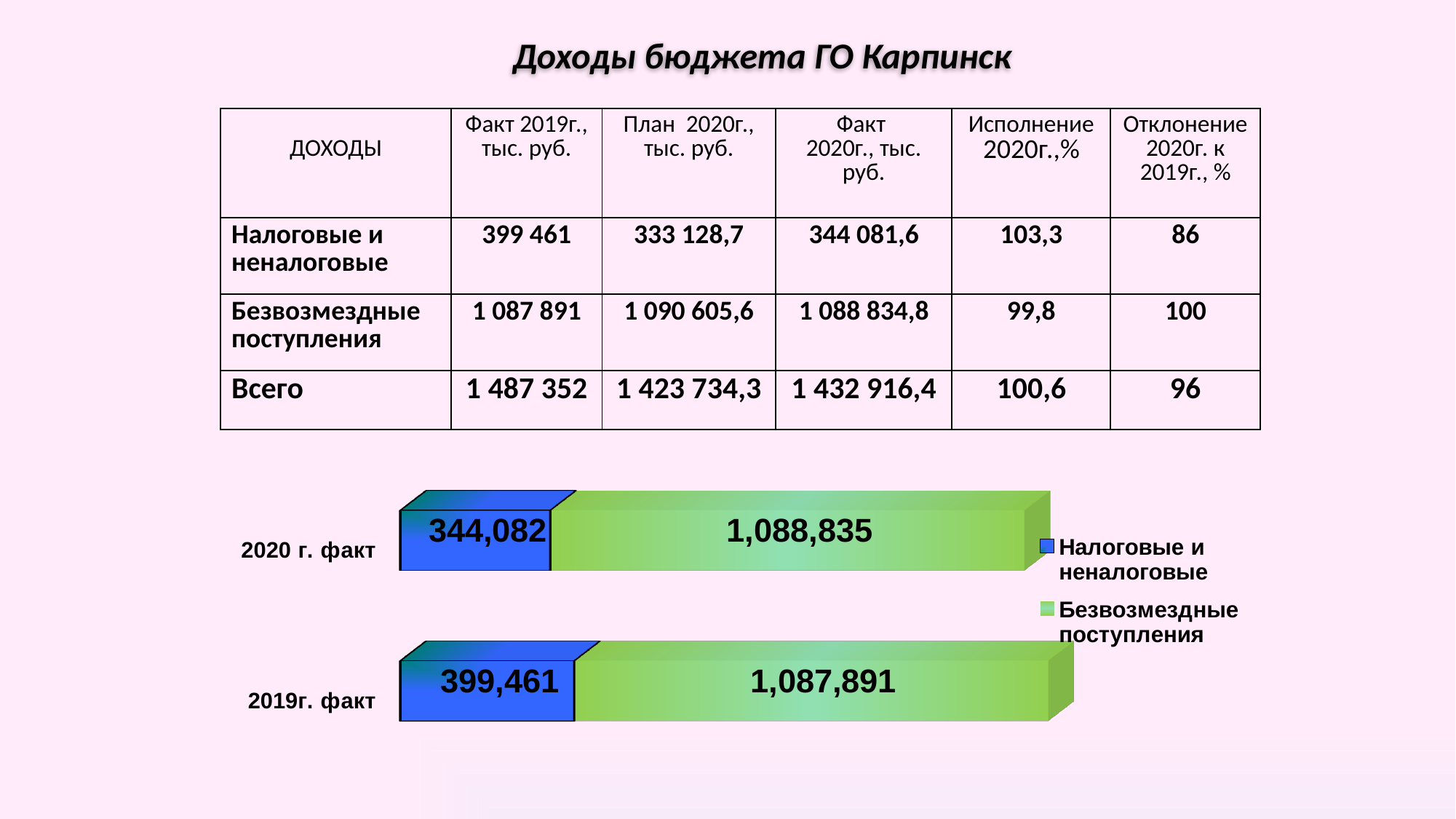
How many series does the chart legend list? 2 In the chart, what is the value of Налоговые и неналоговые for 2019г. факт? 399,461 In the chart, what is the value of Безвозмездные поступления for 2020 г. факт? 1,088,835 In the chart, what is the value of Налоговые и неналоговые for 2020 г. факт? 344,082 What kind of chart is shown on the slide? Stacked bar chart How many categories (bars) are shown in the chart? 2 In the chart, what is the total of the stacked bar for 2020 г. факт? 1,432,917 In the chart, which series is shown in blue? Налоговые и неналоговые In the chart, what is the total of the stacked bar for 2019г. факт? 1,487,352 In the chart, what is the difference between the Налоговые и неналоговые values for 2019г. факт and 2020 г. факт? 55,379 In the chart, what is the value of Безвозмездные поступления for 2019г. факт? 1,087,891 In the chart, which year has the higher value for Налоговые и неналоговые, 2020 г. факт or 2019г. факт? 2019г. факт